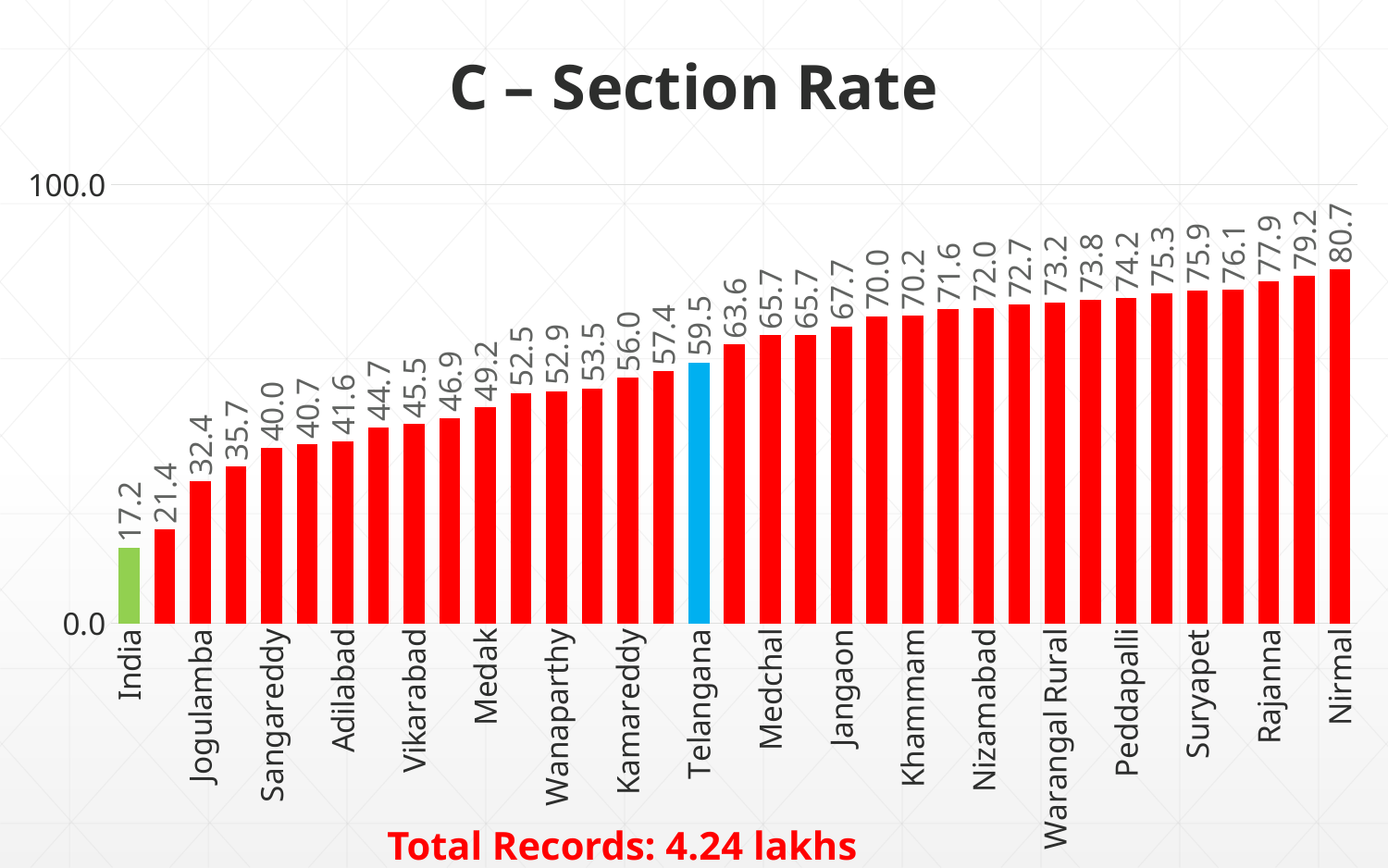
Which category has the lowest C-section rate? India What is the difference between the values for Telangana and India? 42.3 Do the values rise or fall moving from left to right along the x axis? Rise What is the difference between the values for Nirmal and India? 63.5 What is the C-section rate shown for Telangana? 59.5 What is the C-section rate shown for India? 17.2 What type of chart is shown on the slide? Bar chart What is the value shown for Nirmal? 80.7 Which has a higher value, Medak or Rajanna? Rajanna Which category has the highest C-section rate? Nirmal What is the value shown for Khammam? 70.2 What is the title of the chart? C – Section Rate